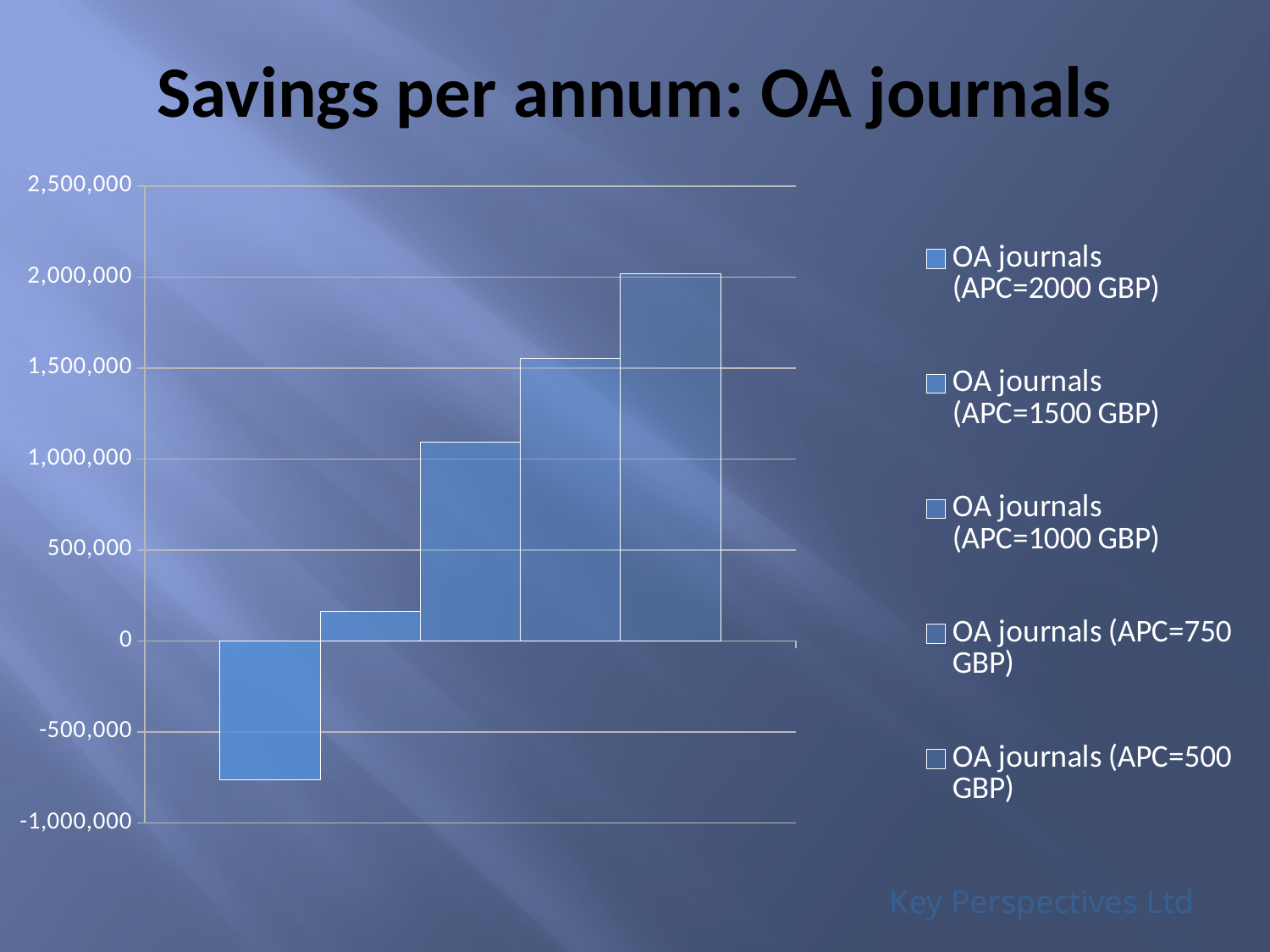
Is the value for OA journals (APC=1000 GBP) greater or less than 500,000? greater What kind of chart is shown on the slide? bar chart Is the value for OA journals (APC=2000 GBP) greater or less than -500,000? less Is the value for OA journals (APC=500 GBP) greater or less than 1,500,000? greater How many series does the legend list? 5 Which series has the lowest savings per annum? OA journals (APC=2000 GBP) Which is larger, the value for OA journals (APC=1000 GBP) or OA journals (APC=1500 GBP)? OA journals (APC=1000 GBP) Which series has the highest savings per annum? OA journals (APC=500 GBP) How many bars are plotted in the chart? 5 What is the title of the chart? Savings per annum: OA journals